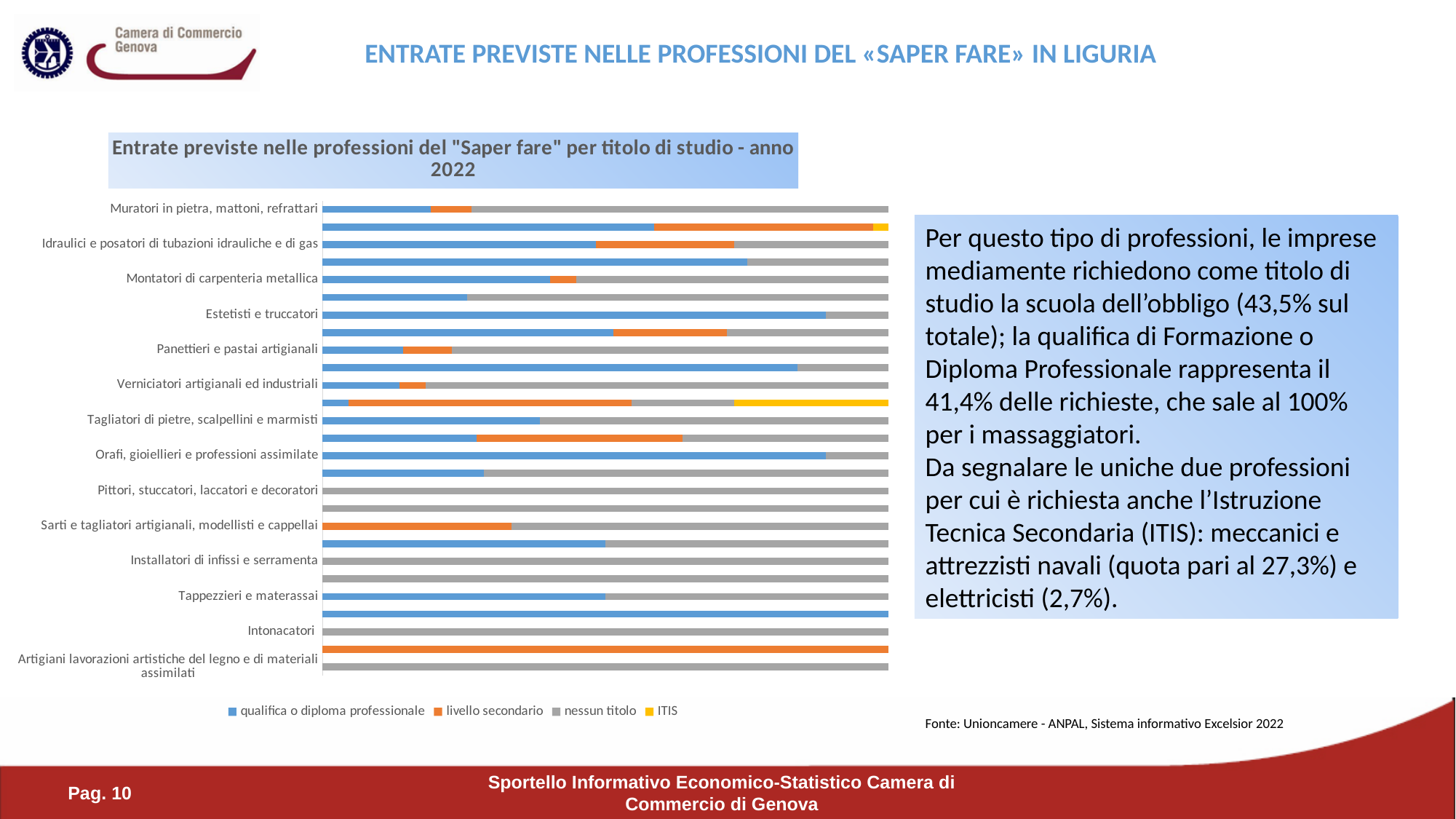
For Intonacatori, which series makes up the entire bar? nessun titolo For Sarti e tagliatori artigianali, modellisti e cappellai, which segment is larger: livello secondario or nessun titolo? nessun titolo For Estetisti e truccatori, which segment is larger: qualifica o diploma professionale or nessun titolo? qualifica o diploma professionale How many category labels are listed on the vertical axis of the chart? 14 What is the title of the chart? Entrate previste nelle professioni del "Saper fare" per titolo di studio - anno 2022 For Orafi, gioiellieri e professioni assimilate, which series has the largest share of the bar? qualifica o diploma professionale For Muratori in pietra, mattoni, refrattari, which series has the largest share of the bar? nessun titolo For Verniciatori artigianali ed industriali, which series has the smallest share of the bar? livello secondario What kind of chart is shown on the slide? Stacked horizontal bar chart How many series does the chart legend list? 4 Which series is shown in yellow in the chart? ITIS For Idraulici e posatori di tubazioni idrauliche e di gas, which segment is larger: livello secondario or nessun titolo? nessun titolo